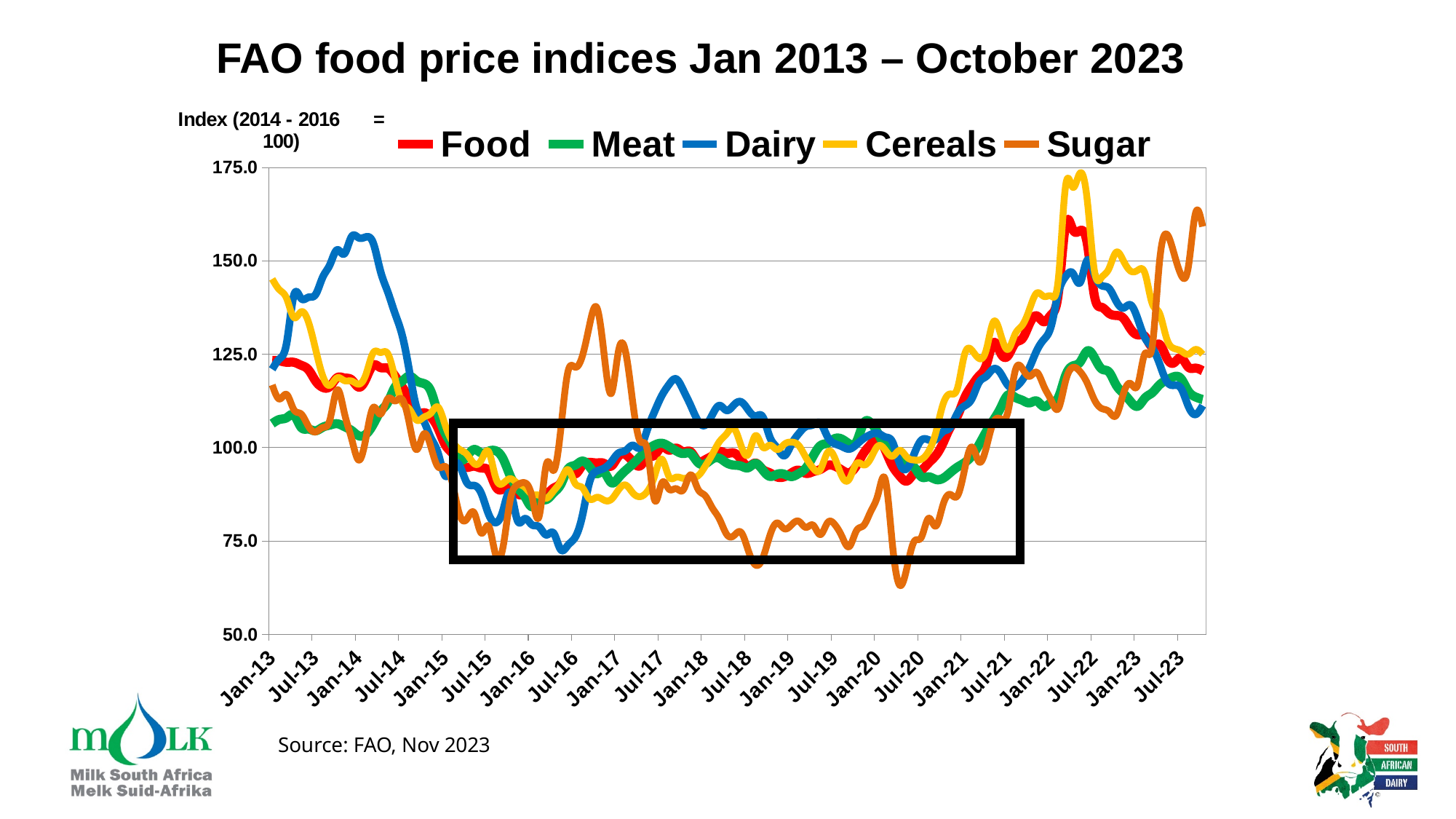
Is the value for Dairy at Jul-16 greater or less than 100? less How many labelled tick marks are on the x axis? 22 At Jan-14, which is higher, Dairy or Sugar? Dairy What is the title of the chart? FAO food price indices Jan 2013 – October 2023 What kind of chart is shown on the slide? Line chart Does the Dairy series rise or fall between Jan-14 and Jul-16? Fall Which series reaches the highest value anywhere on the chart? Cereals How many series does the legend list? 5 Which colour is used for the Dairy series in the legend? Blue Is the value for Dairy at Jan-14 greater or less than 125? greater Which series reaches the lowest value anywhere on the chart? Sugar Is the value for Cereals at Jan-13 greater or less than 125? greater